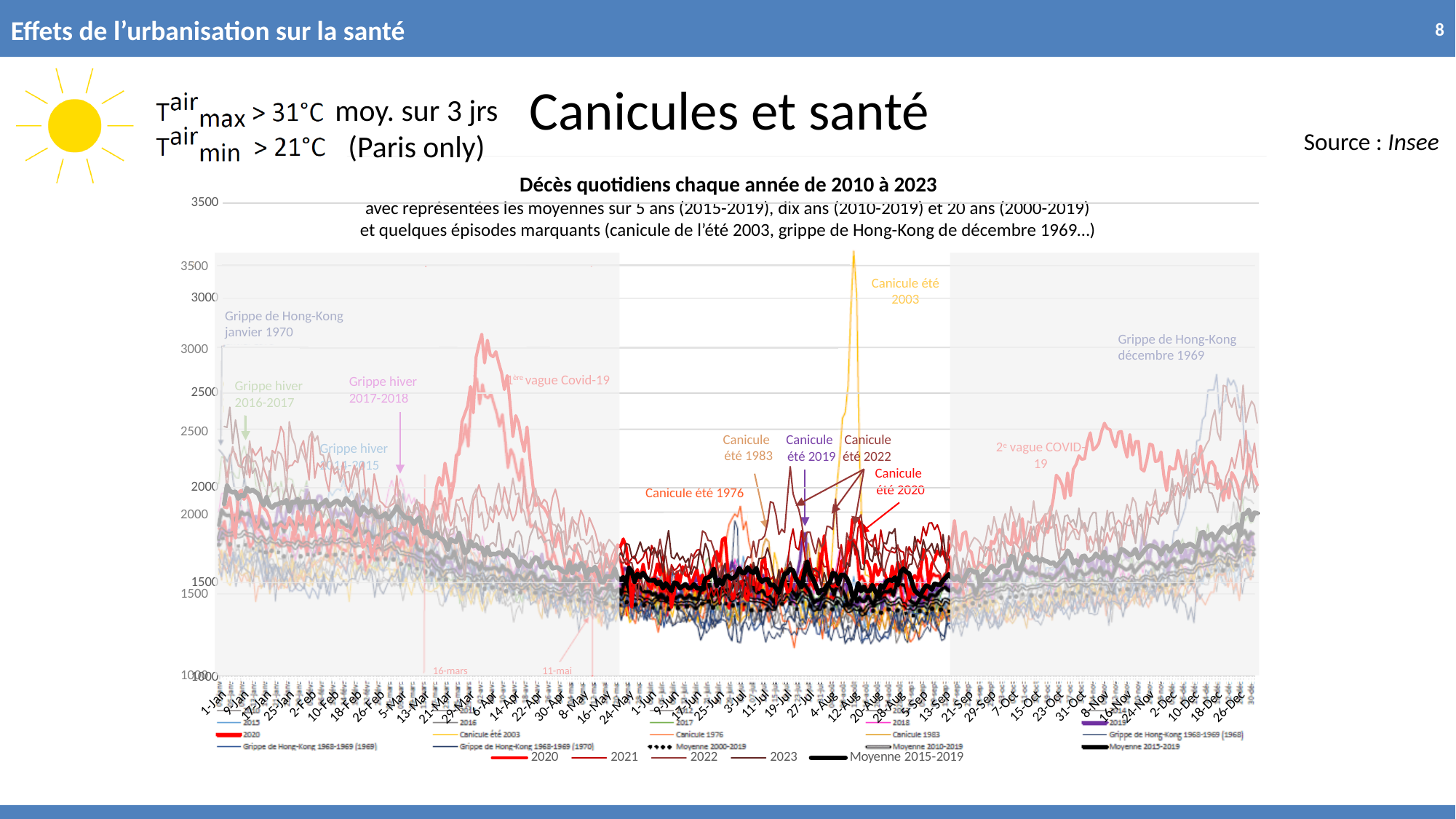
What kind of chart is shown on the slide? line chart Which peak is higher: '1ère vague Covid-19' or 'Grippe de Hong-Kong décembre 1969'? 1ère vague Covid-19 Is the 'Moyenne 2015-2019' line during June to August greater or less than 2000? less Is the peak of the 'Canicule été 2003' line greater or less than 3000? greater Is the peak of the '1ère vague Covid-19' line greater or less than 2500? greater Does the thick grey average line rise or fall from January to June? fall How many 'Canicule' (heatwave) episodes are annotated on the chart? 6 Which annotated episode reaches the highest number of daily deaths on the chart? Canicule été 2003 What source is cited for the chart? Insee Which peak is higher: 'Canicule été 2003' or '1ère vague Covid-19'? Canicule été 2003 What is the title of the chart? Décès quotidiens chaque année de 2010 à 2023